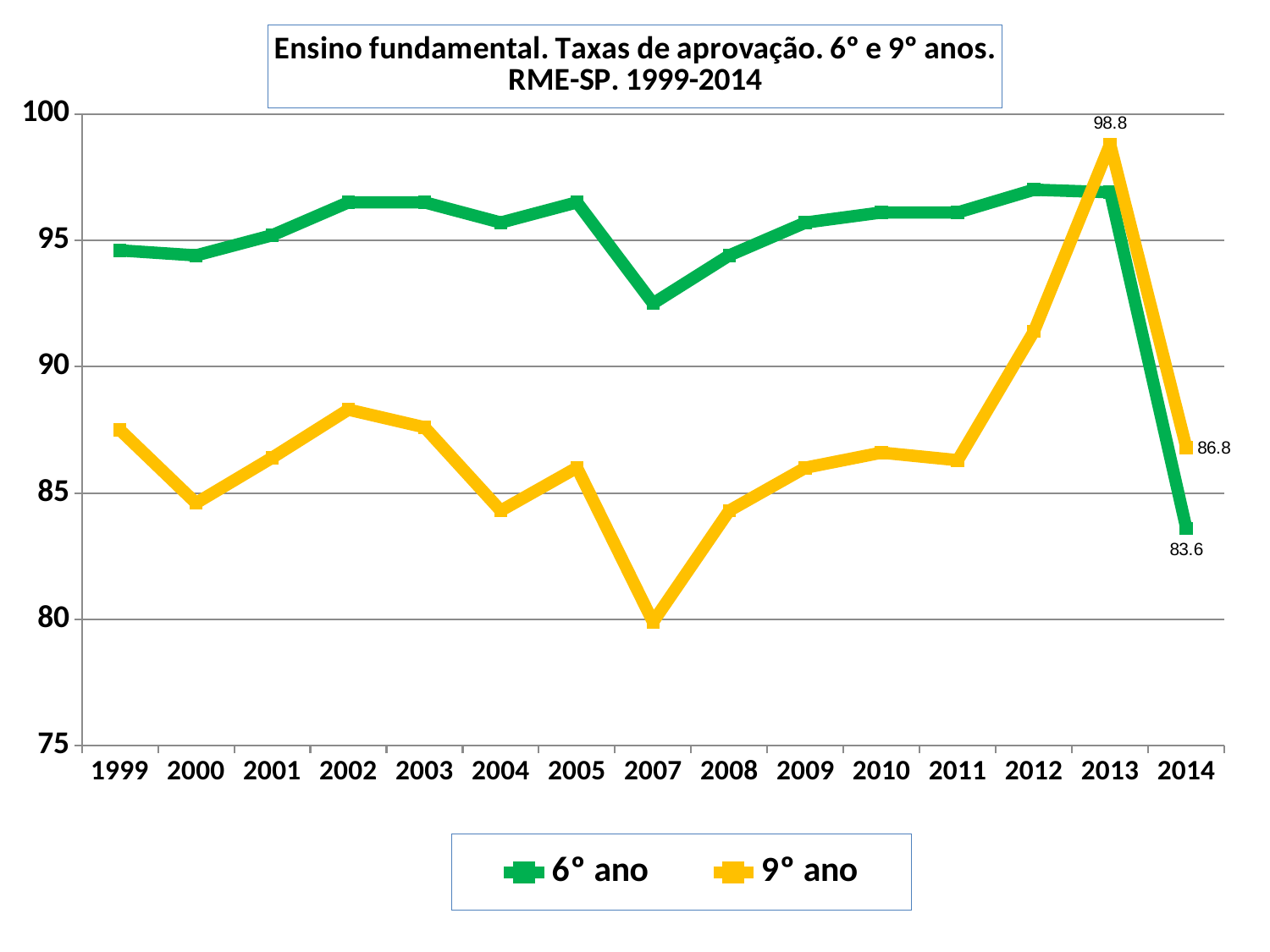
How many series does the legend list? 2 How many years are shown on the x axis? 15 Is the value for 6° ano in 2007 greater or less than 95? less By how much did the 9° ano value fall from 2013 to 2014? 12.0 In which year is the 6° ano value lowest? 2014 In which year is the 9° ano value lowest? 2007 In 2014, which series has the higher value, 6° ano or 9° ano? 9° ano What is the value for 9° ano in 2013? 98.8 What is the value for 9° ano in 2014? 86.8 What is the value for 6° ano in 2014? 83.6 What is the difference between the 9° ano and 6° ano values in 2014? 3.2 What kind of chart is shown on the slide? line chart